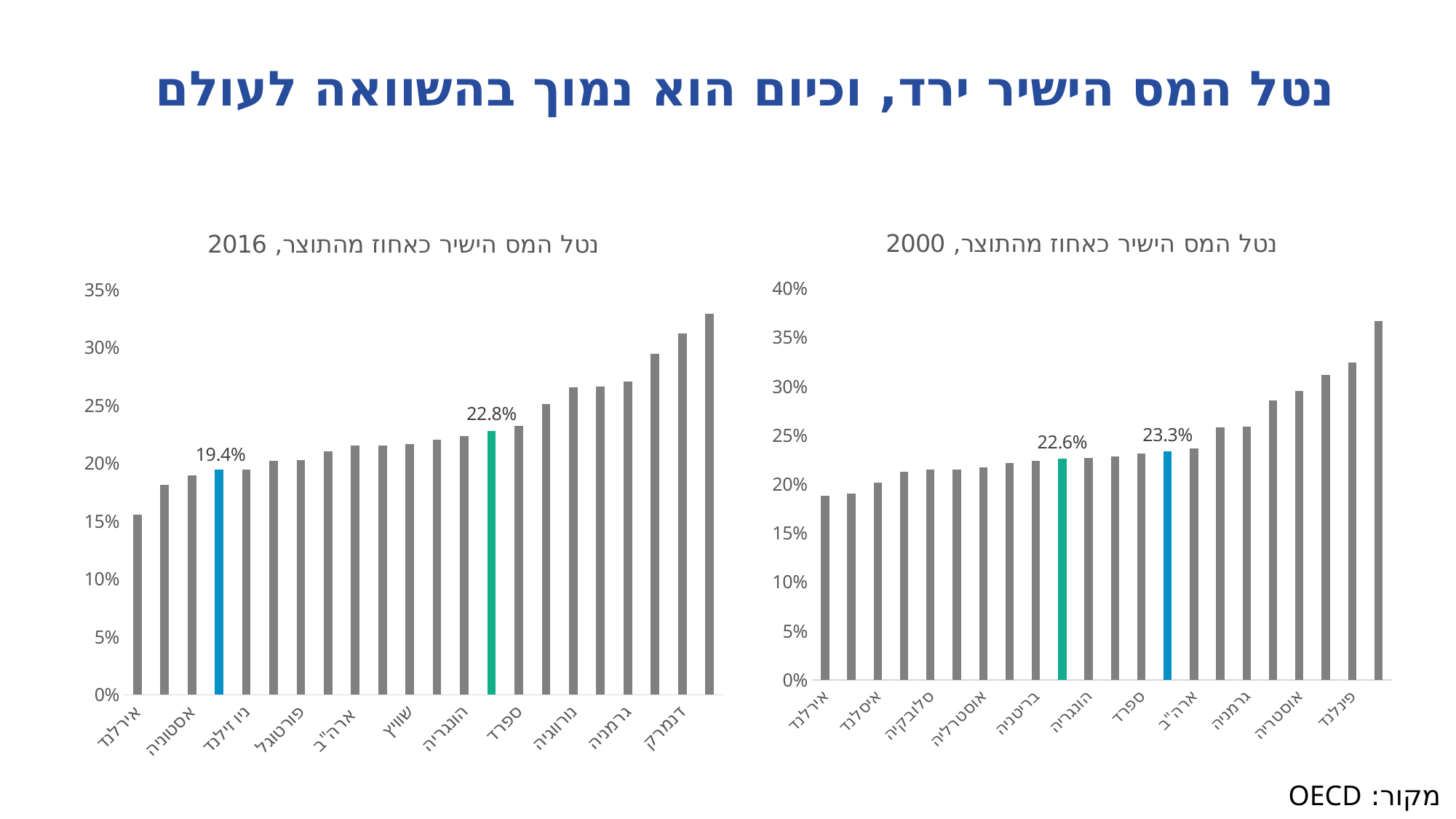
In the 2000 chart (right), is the tallest bar greater or less than 35%? greater In the 2000 chart (right), what value is labelled on the blue highlighted bar? 23.3% In the 2016 chart (left), is the value for אירלנד greater or less than 20%? less In the 2000 chart (right), what value is labelled on the green highlighted bar? 22.6% In the 2000 chart (right), which highlighted bar is larger, the blue one or the green one? The blue one (23.3%) In the 2000 chart (right), do the bar values rise or fall from left to right? Rise In the 2016 chart (left), what is the difference between the green bar's value and the blue bar's value? 3.4 percentage points In the 2016 chart (left), what value is labelled on the green highlighted bar? 22.8% In the 2016 chart (left), what value is labelled on the blue highlighted bar? 19.4% What kind of chart is the left chart titled 'נטל המס הישיר כאחוז מהתוצר, 2016'? Bar chart What source is cited at the bottom of the slide for the charts? OECD In the 2016 chart (left), which country has the lowest value? אירלנד